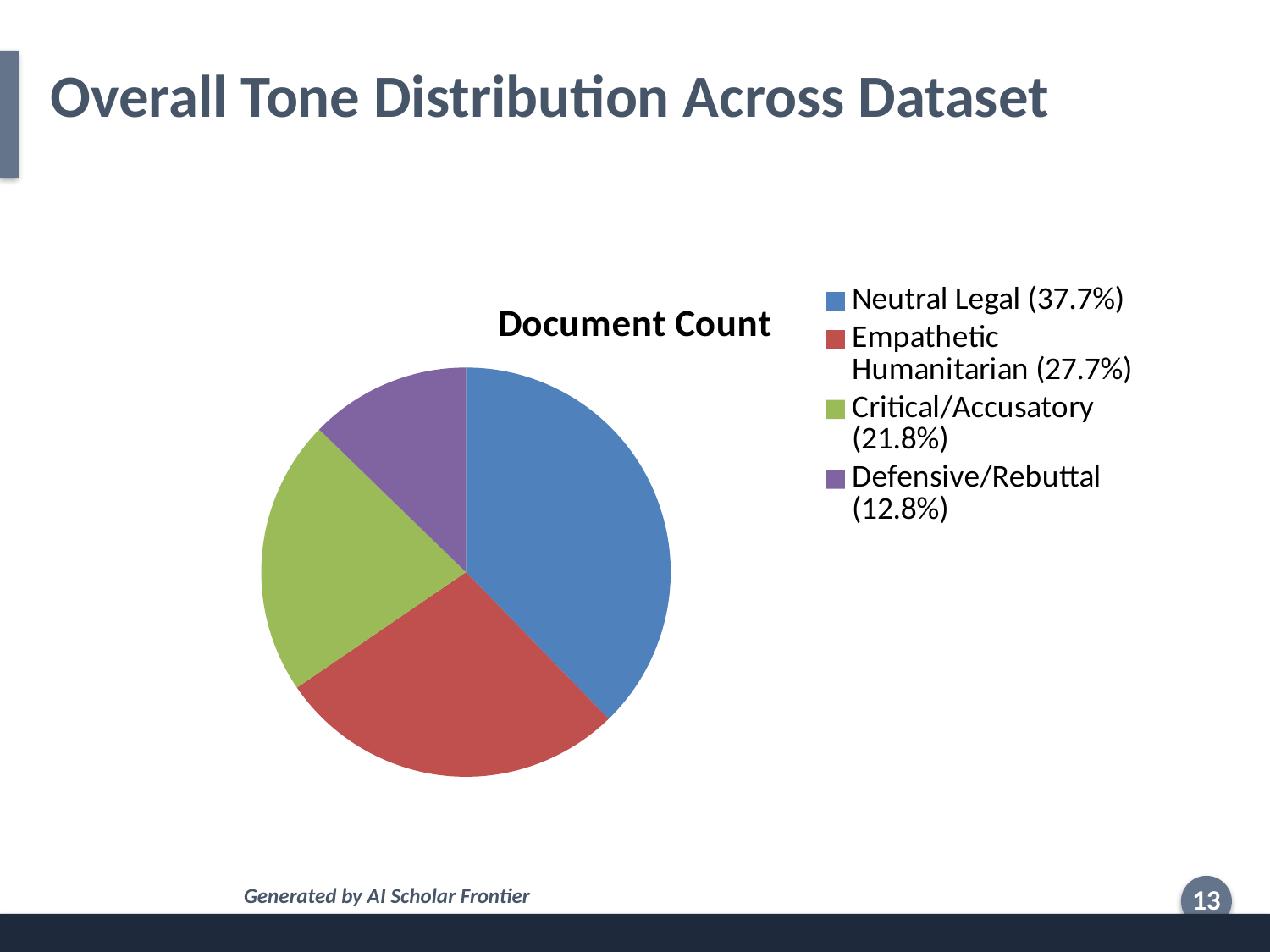
What colour is the Critical/Accusatory slice? green What share of the pie does Defensive/Rebuttal represent? 12.8% Which tone category has the largest slice of the pie? Neutral Legal Which tone category has the smallest slice of the pie? Defensive/Rebuttal What share of the pie does Critical/Accusatory represent? 21.8% Which slice is larger, Empathetic Humanitarian or Critical/Accusatory? Empathetic Humanitarian What is the title of the chart? Document Count What share of the pie does Empathetic Humanitarian represent? 27.7% How many slices does the pie chart have? 4 What kind of chart is shown on the slide? pie chart What is the difference in percentage points between the Neutral Legal share and the Defensive/Rebuttal share? 24.9